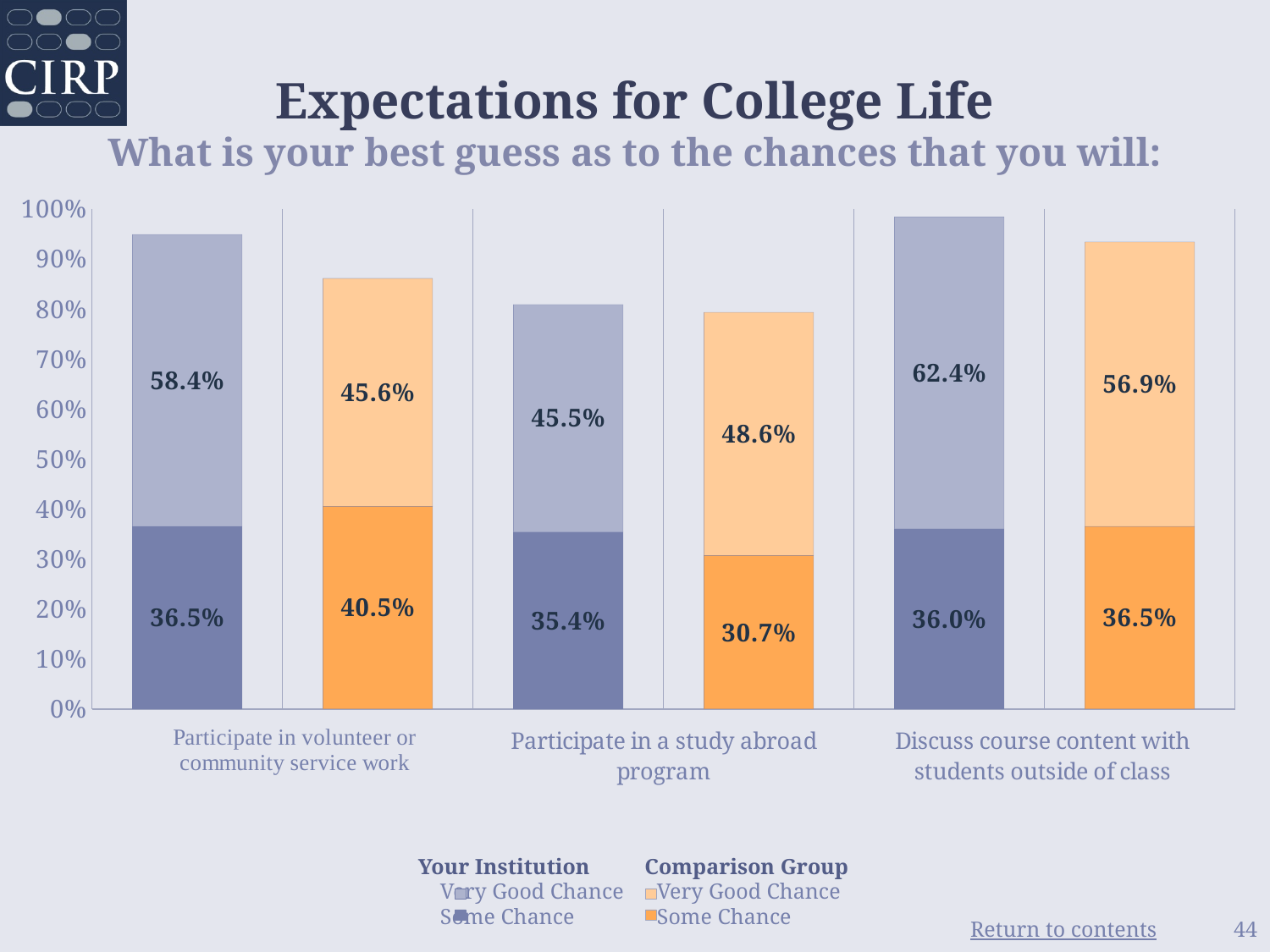
Which category has the lowest 'Some Chance' value for the Comparison Group? Participate in a study abroad program What is the total height of the stacked bar for Your Institution for 'Discuss course content with students outside of class'? 98.4% What is the 'Very Good Chance' value for the Comparison Group for 'Discuss course content with students outside of class'? 56.9% For 'Participate in a study abroad program', which group has the larger 'Very Good Chance' value, Your Institution or the Comparison Group? Comparison Group What is the 'Very Good Chance' value for Your Institution for 'Participate in volunteer or community service work'? 58.4% Across the three categories, which has the highest 'Very Good Chance' value for Your Institution? Discuss course content with students outside of class What is the total height of the stacked bar for the Comparison Group for 'Participate in volunteer or community service work'? 86.1% What kind of chart is shown on the slide? Stacked bar chart How many series does the legend list? 4 What is the difference between the 'Very Good Chance' values for Your Institution and the Comparison Group for 'Participate in volunteer or community service work'? 12.8% How many categories are shown on the x axis? 3 What is the 'Some Chance' value for the Comparison Group for 'Participate in a study abroad program'? 30.7%